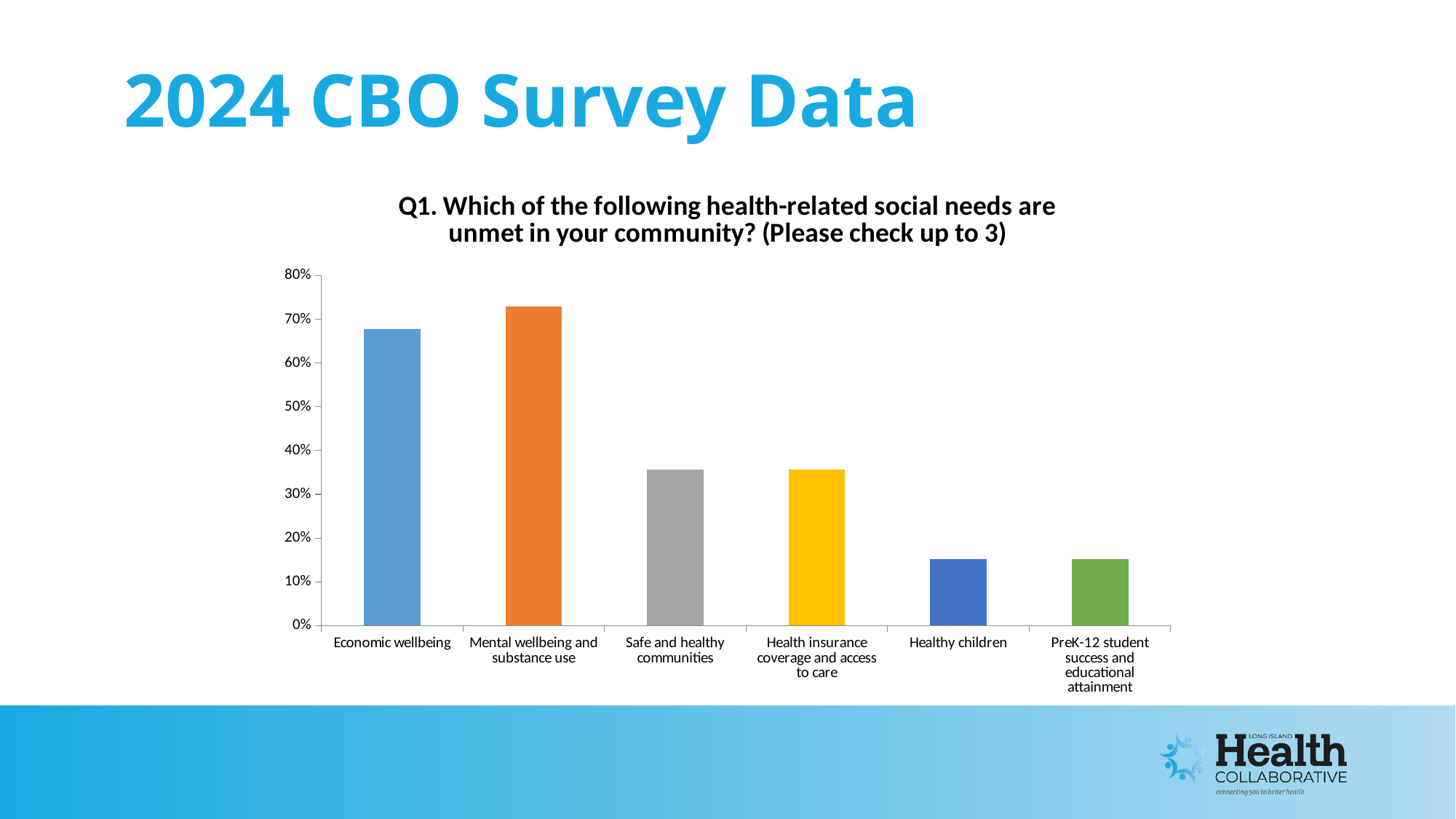
How many categories are shown on the x axis of the chart? 6 From Mental wellbeing and substance use to PreK-12 student success and educational attainment, do the values rise or fall along the x axis? fall Which is larger: the value for Economic wellbeing or the value for Safe and healthy communities? Economic wellbeing Is the value for Healthy children greater or less than 20%? less Is the value for Safe and healthy communities greater or less than 40%? less What colour is the bar for Mental wellbeing and substance use? Orange Is the value for PreK-12 student success and educational attainment greater or less than 10%? greater Which category has the highest value in the chart? Mental wellbeing and substance use What kind of chart is shown on the slide? Bar chart